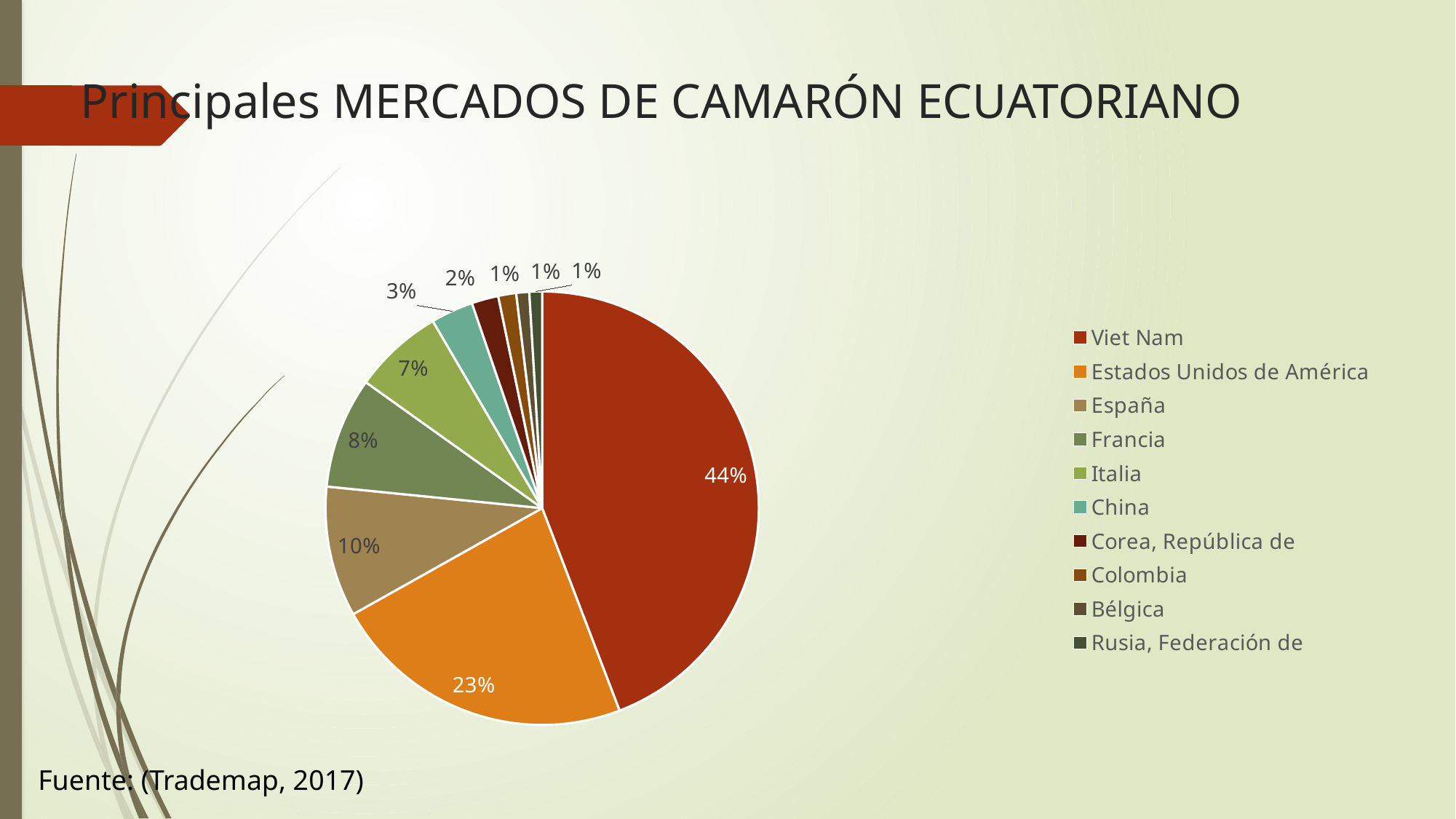
Which market has the largest slice of the pie? Viet Nam How many markets are listed in the legend? 10 What is the value shown for Francia? 8% What kind of chart is shown on the slide? pie chart Which is larger, the share for Francia or the share for Italia? Francia What is the value shown for España? 10% What is the value shown for China? 3% What is the title of the slide containing the chart? Principales MERCADOS DE CAMARÓN ECUATORIANO What share of the pie does Viet Nam hold? 44% What is the difference between the shares of Viet Nam and Estados Unidos de América? 21% What is the value shown for Italia? 7% What share of the pie does Estados Unidos de América hold? 23%